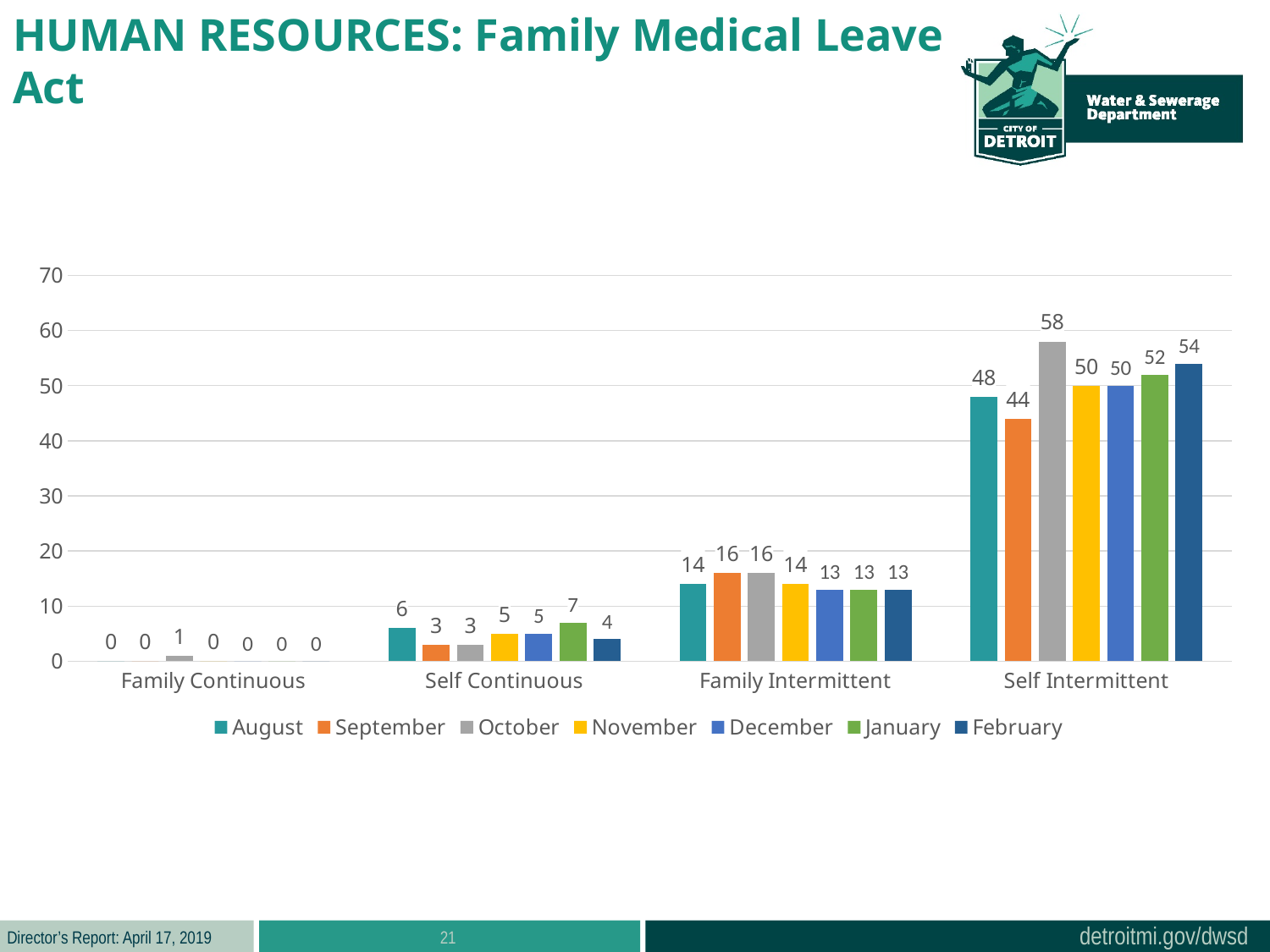
What is the difference between the October and September values in the Self Intermittent category? 14 Which month has the highest value in the Self Intermittent category? October What is the value for January in the Self Continuous category? 7 What is the value for February in the Self Intermittent category? 54 What is the value for August in the Family Intermittent category? 14 Which is larger in the Self Continuous category, the August value or the February value? August What kind of chart is shown on the slide? Bar chart What is the value for October in the Self Intermittent category? 58 How many series does the legend list? 7 Which month is the only one with a non-zero value in the Family Continuous category? October Which month has the lowest value in the Self Intermittent category? September How many categories are shown on the x axis? 4